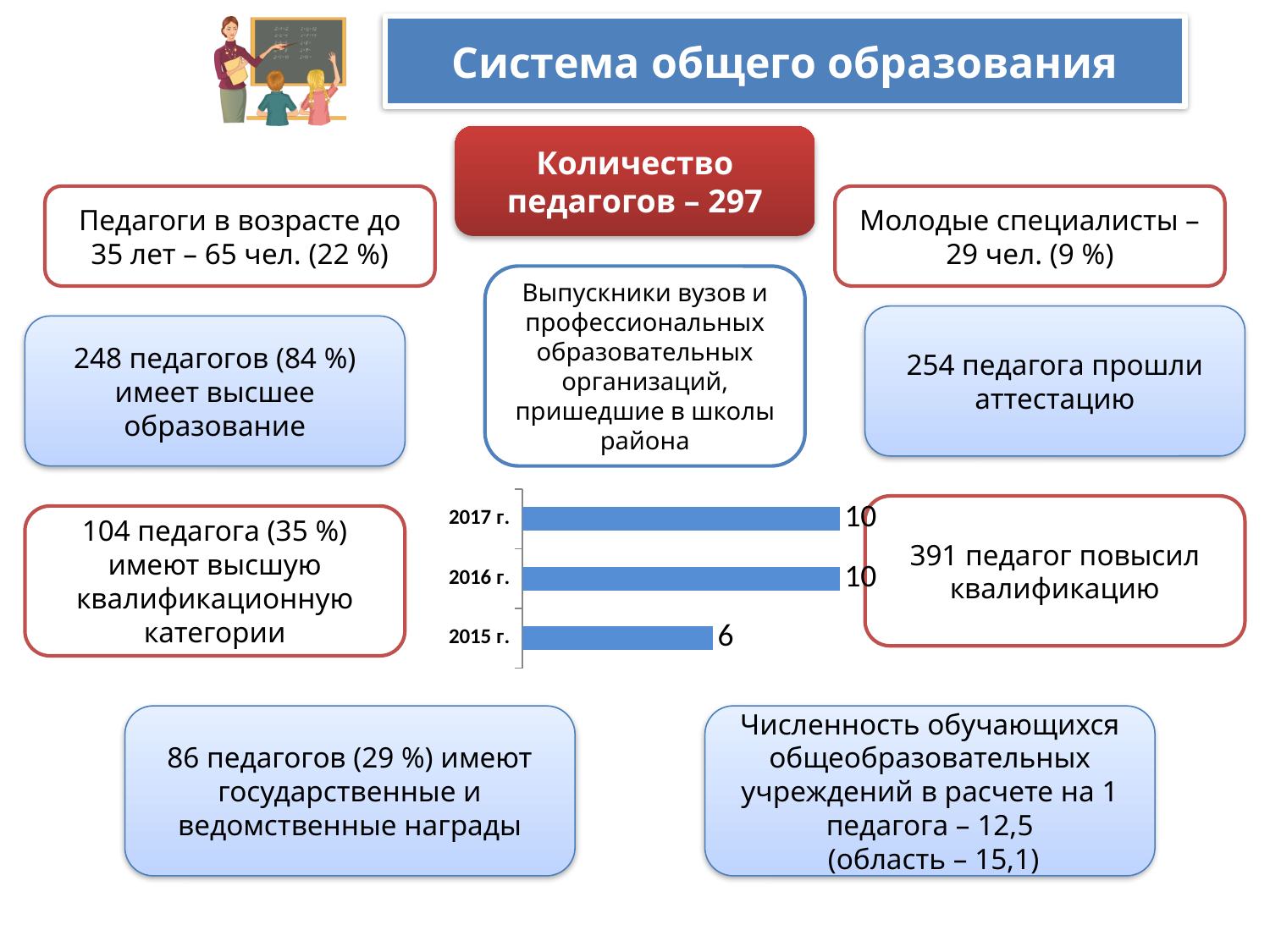
What kind of chart is shown on the slide? bar chart Do the values in the bar chart rise or fall from 2015 г. to 2017 г.? rise Which year has the lowest value in the bar chart? 2015 г. What is the value for 2017 г. in the bar chart? 10 Which is larger in the bar chart, the value for 2016 г. or the value for 2015 г.? 2016 г. How many years (categories) are shown in the bar chart? 3 What is the difference between the values for 2017 г. and 2015 г. in the bar chart? 4 Are the values for 2017 г. and 2016 г. in the bar chart equal? yes What does the box above the bar chart say the chart is about? Выпускники вузов и профессиональных образовательных организаций, пришедшие в школы района What is the value for 2016 г. in the bar chart? 10 What is the value for 2015 г. in the bar chart? 6 What colour are the bars in the chart? blue